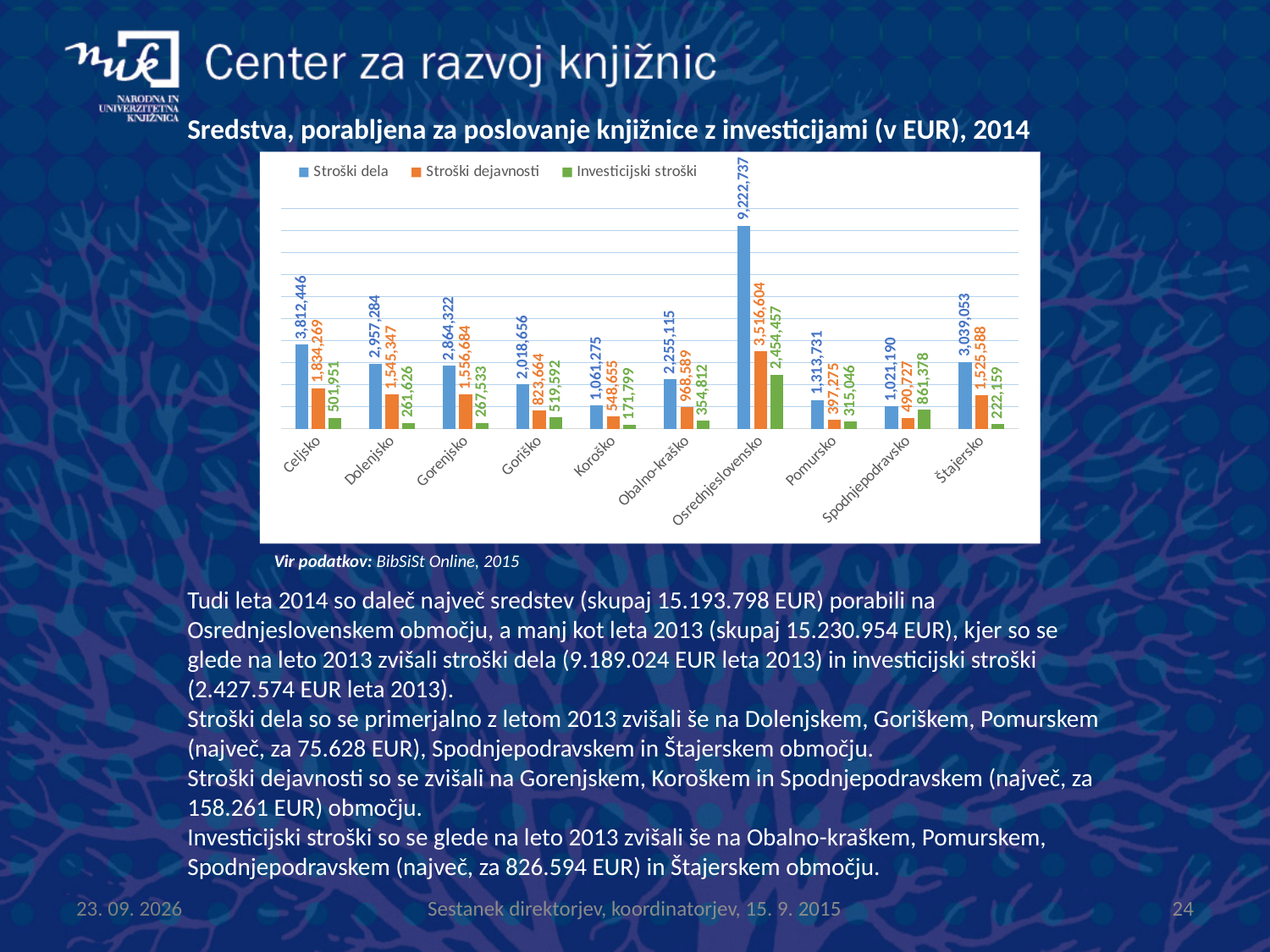
What is the value of Investicijski stroški for Spodnjepodravsko? 861,378 Which region has the lowest Investicijski stroški? Koroško How many regions (categories) are shown on the x axis? 10 How many series does the legend list? 3 Which region has the highest Stroški dela? Osrednjeslovensko What is the value of Stroški dela for Celjsko? 3,812,446 Which region has the lowest Stroški dela? Spodnjepodravsko What is the difference between Stroški dela and Stroški dejavnosti for Celjsko? 1,978,177 For Spodnjepodravsko, which is larger: Stroški dejavnosti or Investicijski stroški? Investicijski stroški What is the title of the chart? Sredstva, porabljena za poslovanje knjižnice z investicijami (v EUR), 2014 What type of chart is shown on the slide? bar chart What is the value of Stroški dejavnosti for Obalno-kraško? 968,589